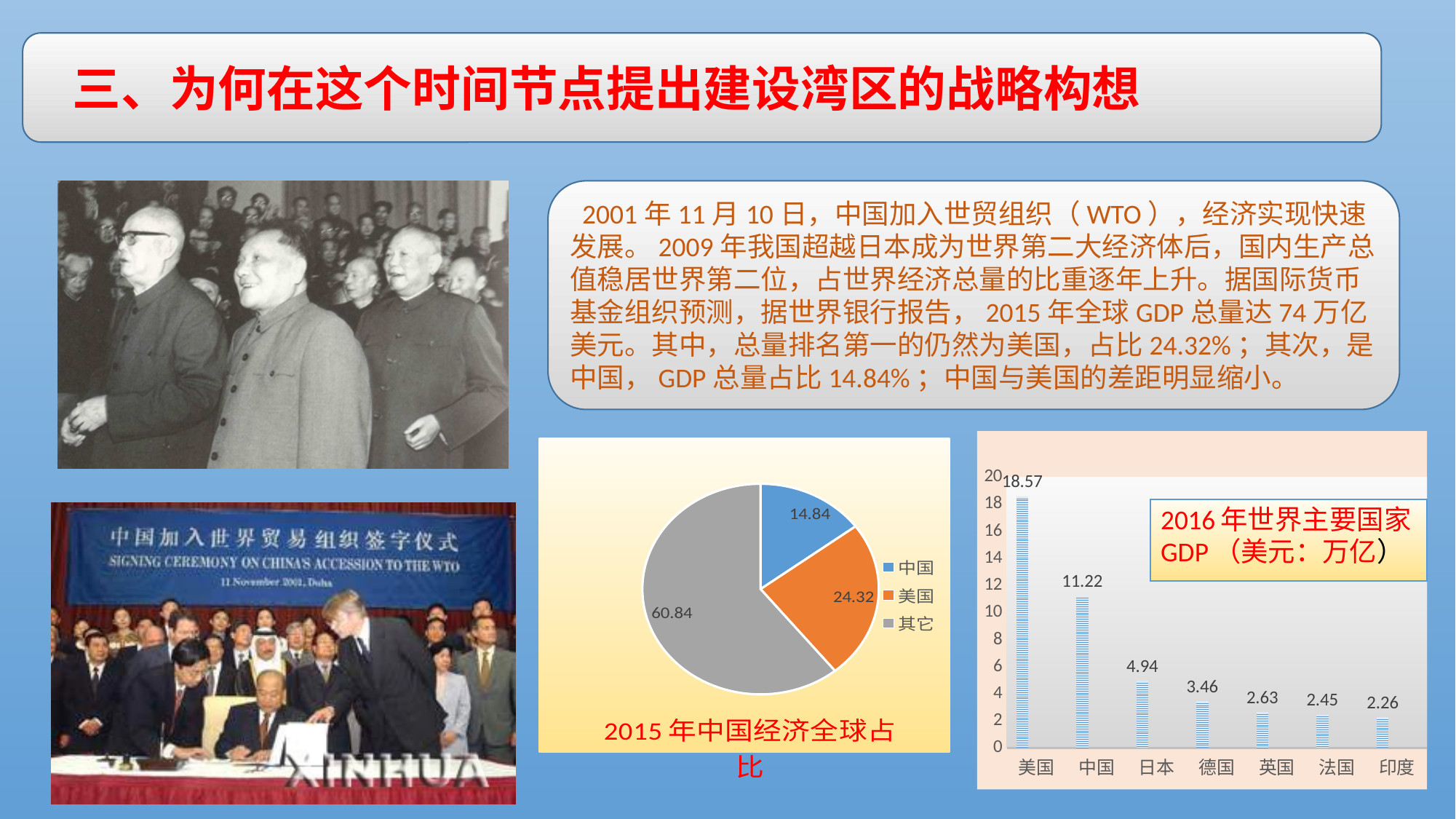
In the bar chart titled 2016年世界主要国家GDP（美元：万亿）, what is the difference between the values for 美国 and 中国? 7.35 In the pie chart titled 2015年中国经济全球占比, which is larger, the value for 中国 or the value for 美国? 美国 In the bar chart titled 2016年世界主要国家GDP（美元：万亿）, which country has the highest value? 美国 In the pie chart titled 2015年中国经济全球占比, how many slices are there? 3 In the bar chart titled 2016年世界主要国家GDP（美元：万亿）, what is the value for 美国? 18.57 In the pie chart titled 2015年中国经济全球占比, which slice is the largest? 其它 In the bar chart titled 2016年世界主要国家GDP（美元：万亿）, which country has the lowest value? 印度 In the bar chart titled 2016年世界主要国家GDP（美元：万亿）, what is the value for 日本? 4.94 In the pie chart titled 2015年中国经济全球占比, what is the value for 美国? 24.32 What kind of chart is the one titled 2016年世界主要国家GDP（美元：万亿）? bar chart In the bar chart titled 2016年世界主要国家GDP（美元：万亿）, is the value for 德国 greater or less than 4? less In the bar chart titled 2016年世界主要国家GDP（美元：万亿）, how many countries are shown? 7